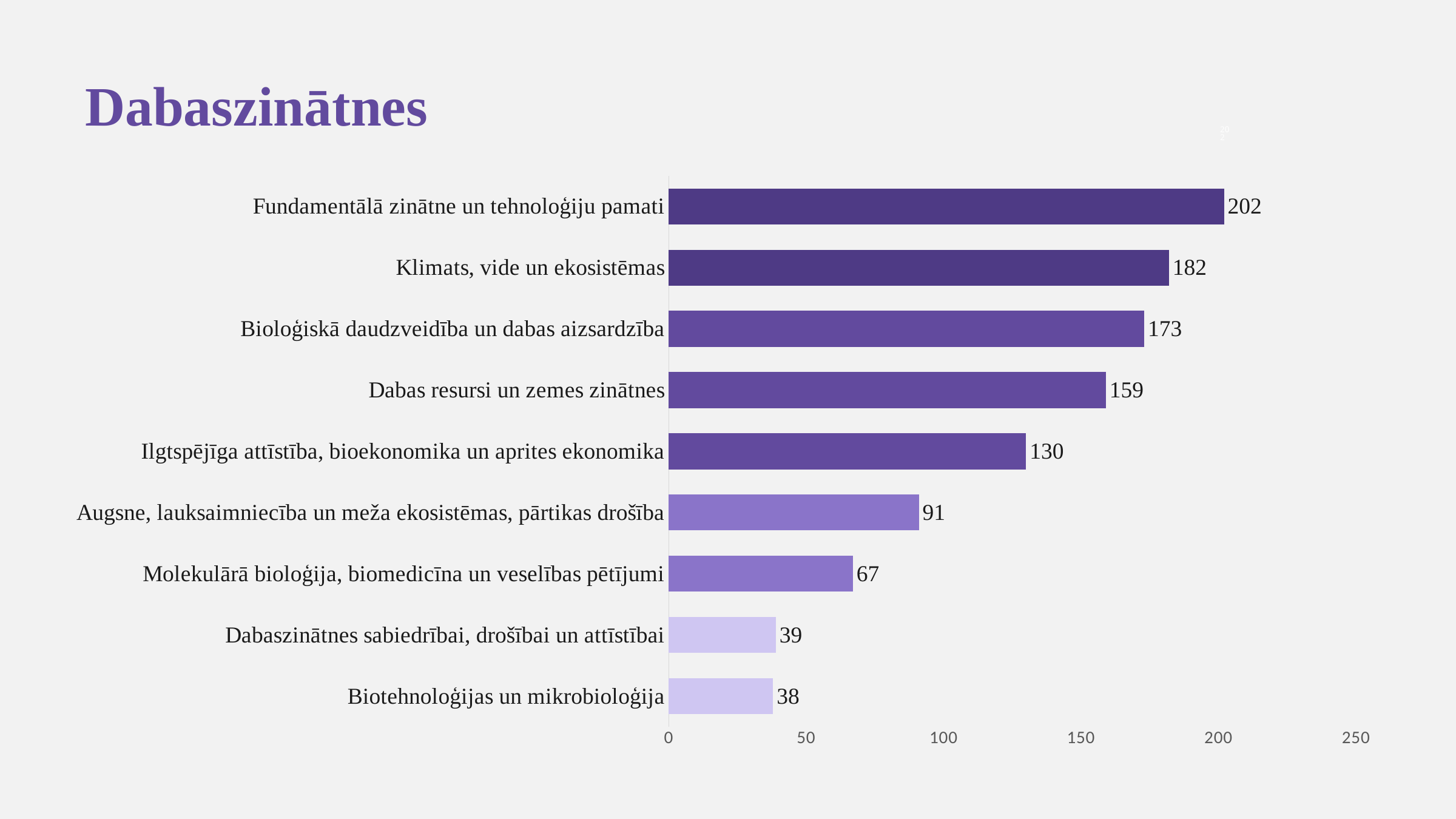
What is the title of the slide? Dabaszinātnes Which category has the highest value? Fundamentālā zinātne un tehnoloģiju pamati Which is larger: the value for Augsne, lauksaimniecība un meža ekosistēmas, pārtikas drošība or the value for Molekulārā bioloģija, biomedicīna un veselības pētījumi? Augsne, lauksaimniecība un meža ekosistēmas, pārtikas drošība What is the value for Molekulārā bioloģija, biomedicīna un veselības pētījumi? 67 What is the difference between the values for Bioloģiskā daudzveidība un dabas aizsardzība and Dabas resursi un zemes zinātnes? 14 Is the value for Dabas resursi un zemes zinātnes greater or less than 150? greater How many categories are shown in the chart? 9 What is the value for Fundamentālā zinātne un tehnoloģiju pamati? 202 What is the value for Klimats, vide un ekosistēmas? 182 What is the value for Ilgtspējīga attīstība, bioekonomika un aprites ekonomika? 130 Which category has the lowest value? Biotehnoloģijas un mikrobioloģija What kind of chart is shown on the slide? bar chart